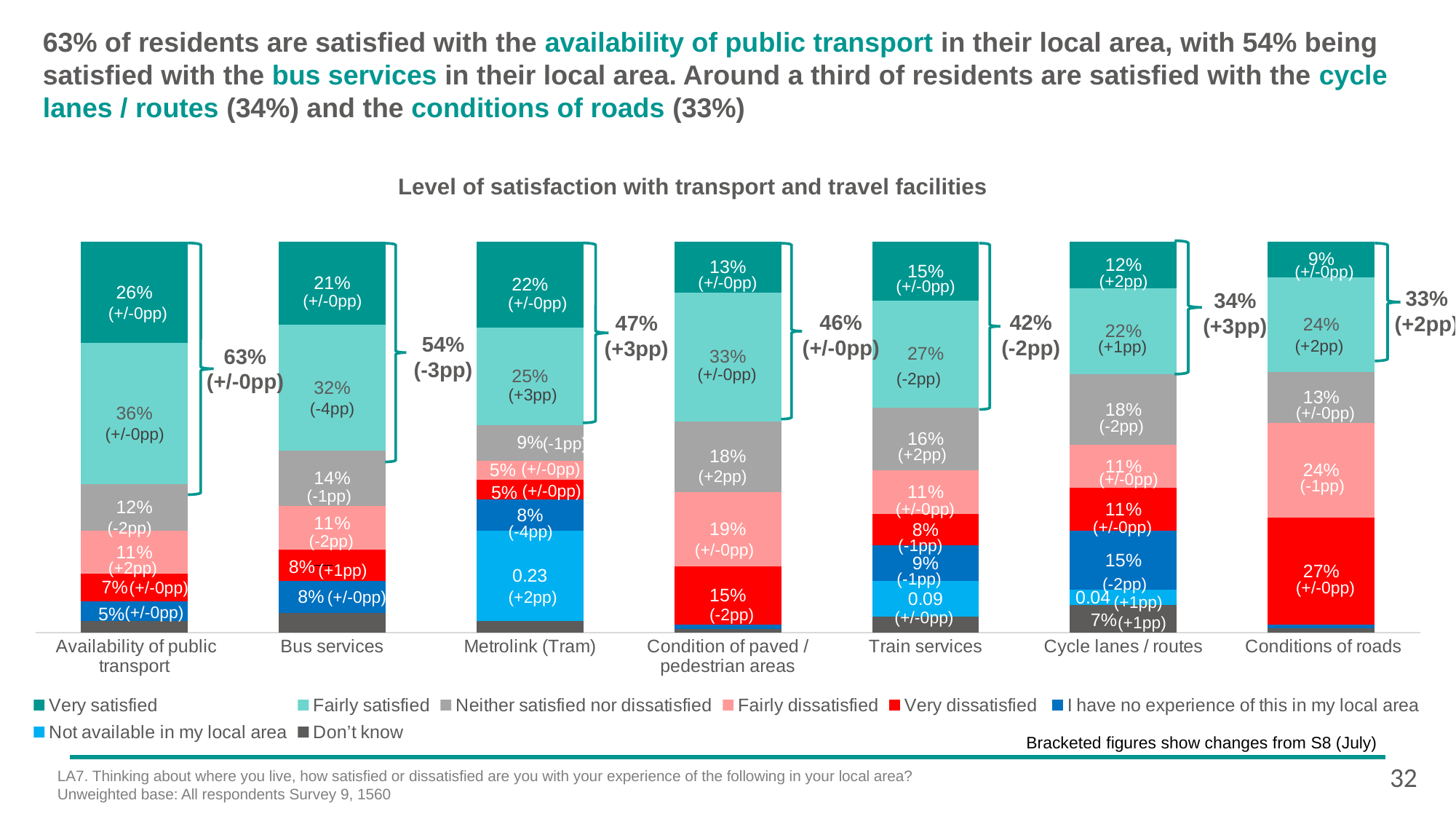
What percentage of residents are very satisfied with the availability of public transport? 26% Which has a larger 'Very dissatisfied' percentage: Conditions of roads or Condition of paved / pedestrian areas? Conditions of roads How many transport and travel facilities (categories) are shown along the x axis? 7 What is the combined satisfied percentage shown for train services? 42% What percentage of residents are neither satisfied nor dissatisfied with cycle lanes / routes? 18% Which category has the highest 'Very satisfied' percentage? Availability of public transport What is the difference between the 'Fairly satisfied' percentage for availability of public transport and for bus services? 4pp What is the title of the chart? Level of satisfaction with transport and travel facilities Which category has the lowest 'Very satisfied' percentage? Conditions of roads What kind of chart is shown on the slide? Stacked bar chart What percentage of residents are very dissatisfied with the conditions of roads? 27% How many series does the legend list? 8